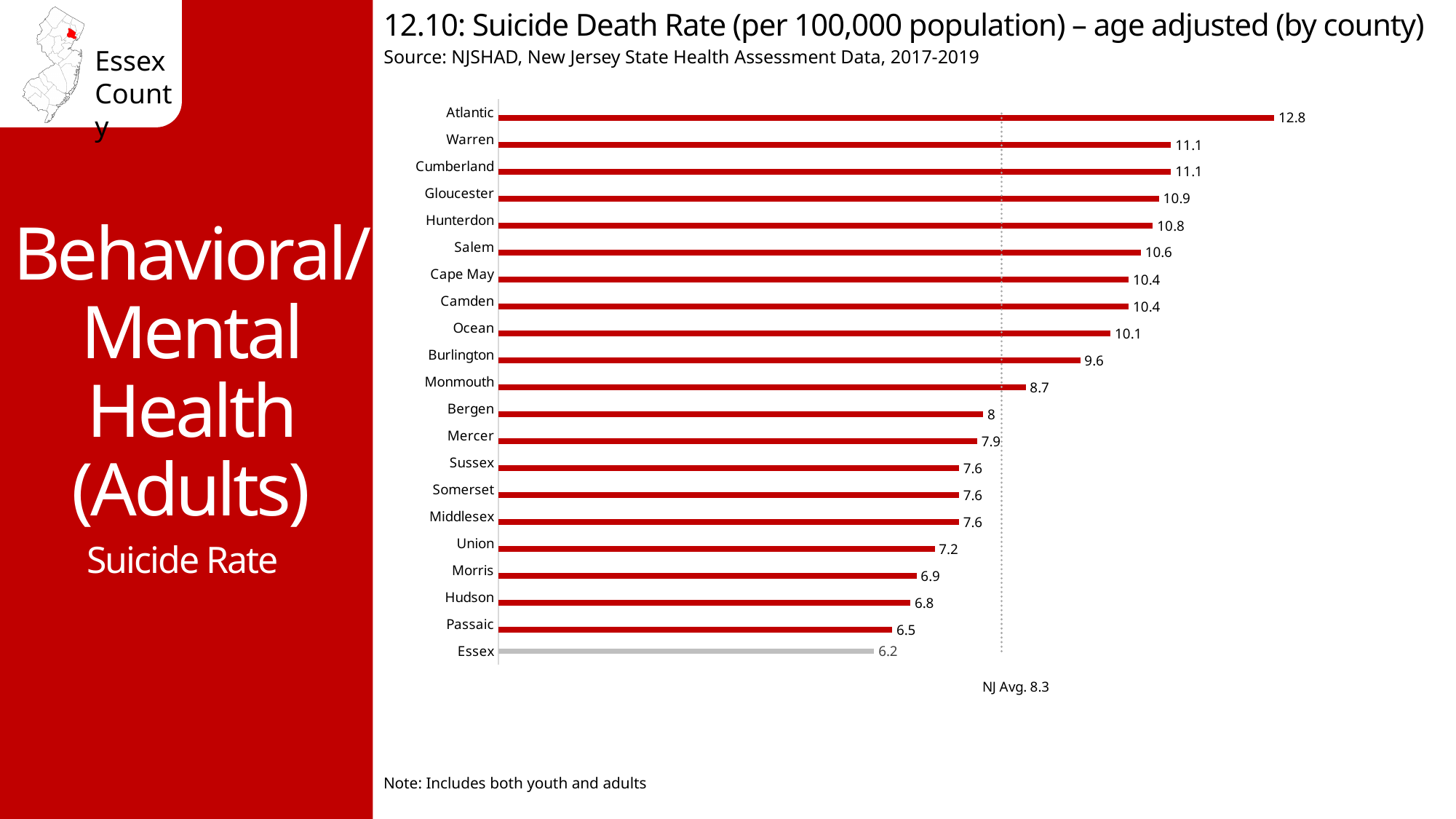
What is the difference between the suicide death rates of Gloucester and Union counties? 3.7 What is the suicide death rate for Essex county? 6.2 What is the difference between the suicide death rates of Atlantic and Essex counties? 6.6 What kind of chart is shown on the slide? Bar chart Which county has a higher suicide death rate, Burlington or Bergen? Burlington What is the NJ average suicide death rate marked on the chart? 8.3 Which county has the highest suicide death rate? Atlantic Which county's bar is coloured grey instead of red? Essex Which county has the lowest suicide death rate? Essex How many counties are shown in the chart? 21 What is the suicide death rate for Atlantic county? 12.8 What is the suicide death rate for Monmouth county? 8.7